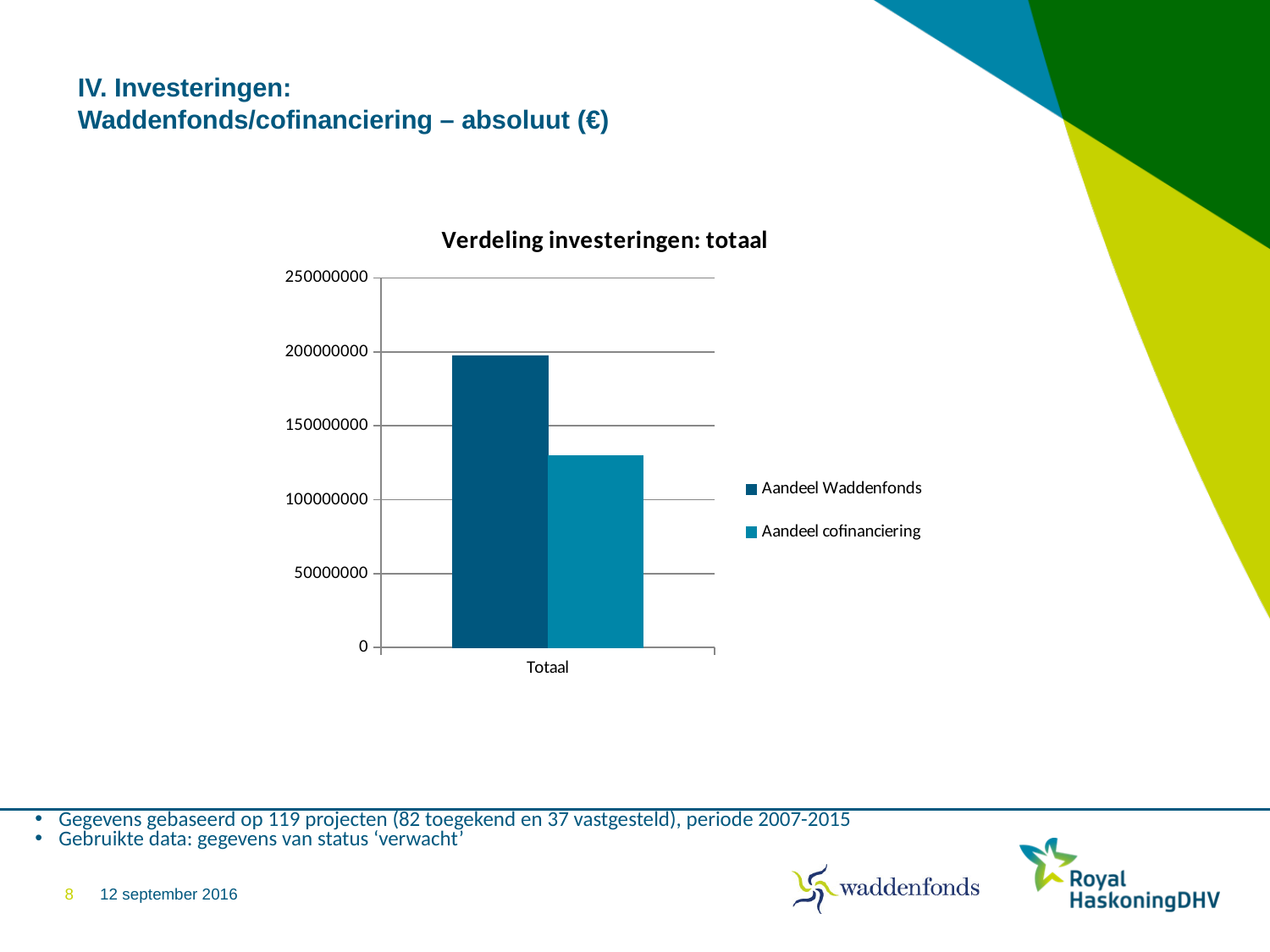
Which series has the highest value in the chart? Aandeel Waddenfonds Which series has the higher value for Totaal? Aandeel Waddenfonds Is the value for Aandeel cofinanciering greater or less than 150000000? less Is the value for Aandeel cofinanciering greater or less than 100000000? greater What is the label of the category on the x axis? Totaal How many categories are shown on the x axis? 1 How many series does the legend list? 2 What is the title of the chart? Verdeling investeringen: totaal Which series has the lowest value in the chart? Aandeel cofinanciering What kind of chart is shown on the slide? bar chart Is the value for Aandeel Waddenfonds greater or less than 150000000? greater